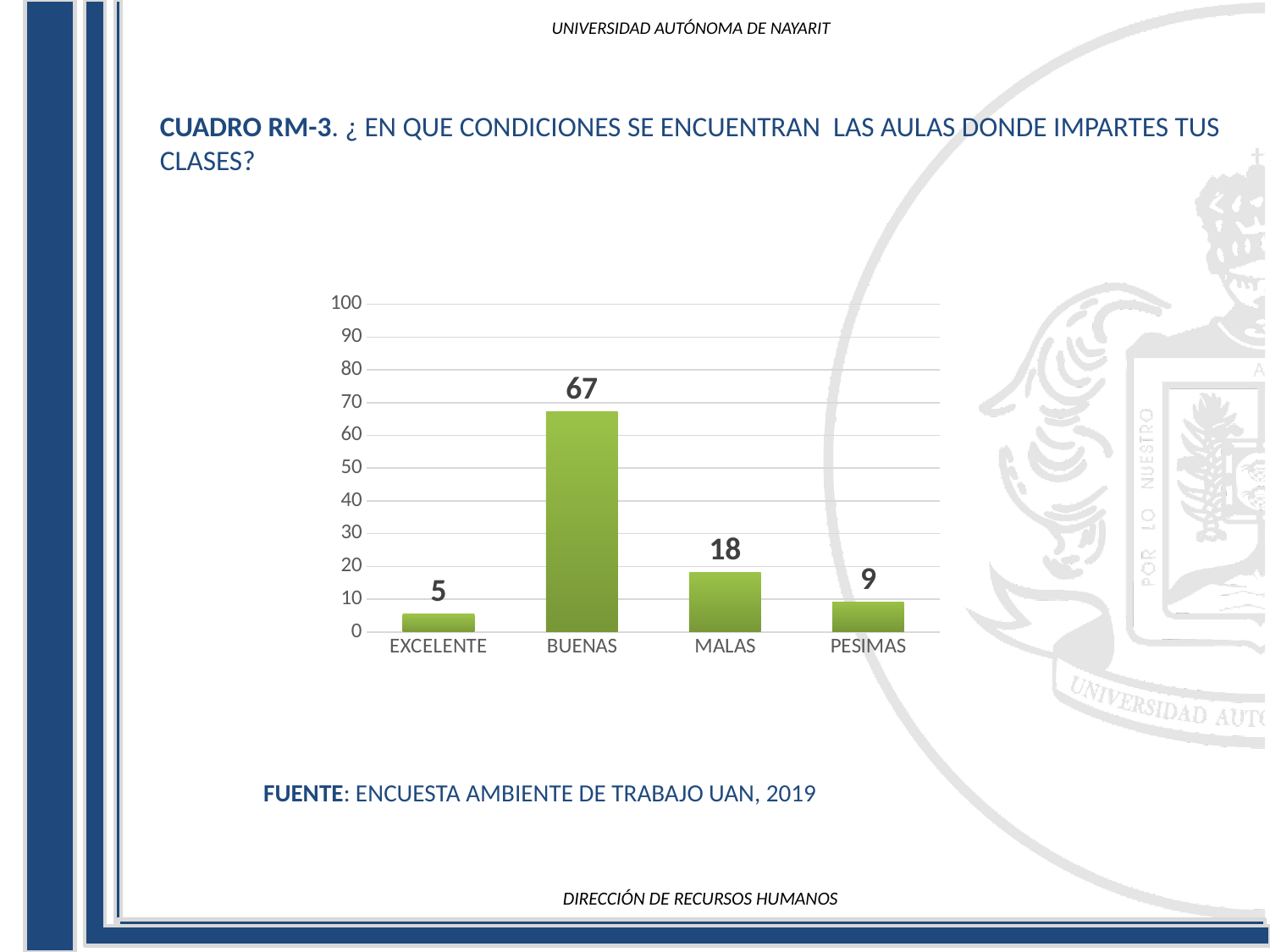
What is the highest value shown on the vertical axis? 100 What is the difference between the values for BUENAS and MALAS? 49 What is the value for BUENAS? 67 Is the value for BUENAS greater or less than 50? greater What is the value for EXCELENTE? 5 Which is larger, the value for MALAS or the value for PESIMAS? MALAS How many categories are shown on the x axis? 4 What is the value for PESIMAS? 9 What kind of chart is shown on the slide? bar chart Which category has the lowest value? EXCELENTE Which category has the highest value? BUENAS What is the value for MALAS? 18